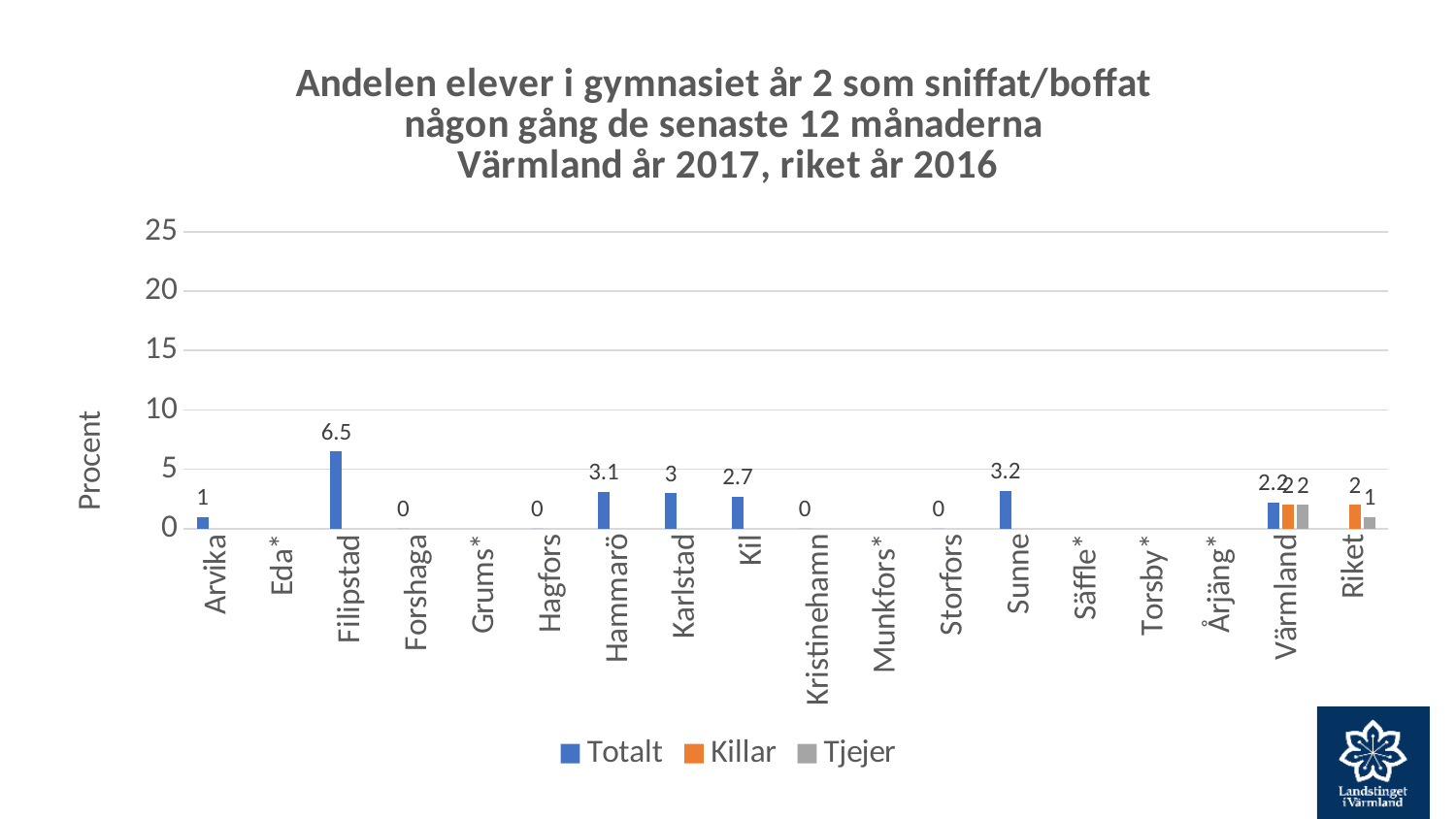
What is the Tjejer value for Riket? 1 What is the label on the y axis? Procent Which category has the highest Totalt value? Filipstad What is the Totalt value for Hammarö? 3.1 How many categories are shown on the x axis? 18 How many series does the legend list? 3 Which has the larger Totalt value, Hammarö or Karlstad? Hammarö Is the Totalt value for Filipstad greater or less than 5? greater What kind of chart is shown on the slide? Bar chart What is the difference between the Totalt values for Filipstad and Sunne? 3.3 What is the Totalt value for Filipstad? 6.5 What is the Totalt value for Sunne? 3.2